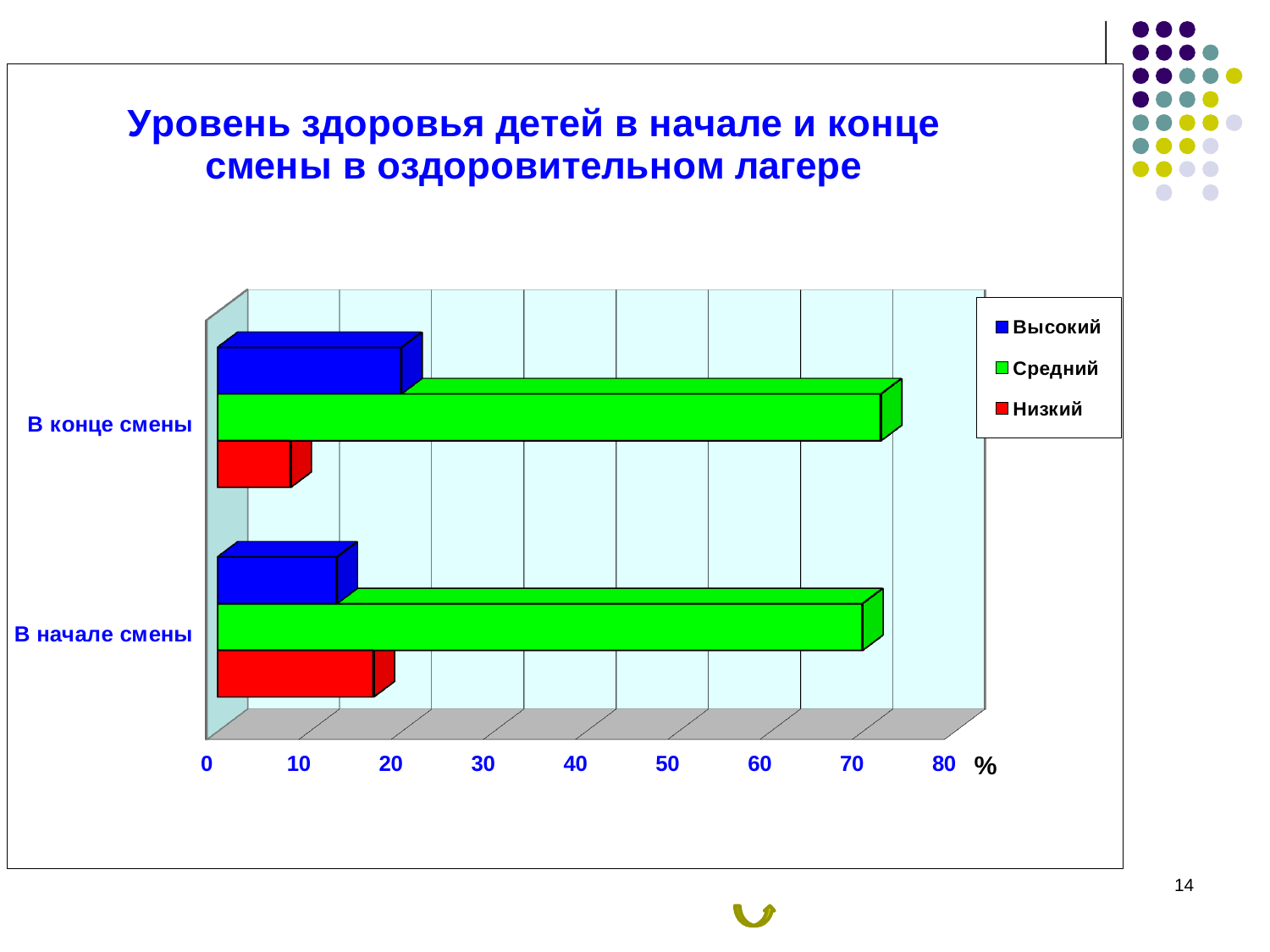
Is the value for "Низкий" in "В начале смены" greater or less than 30? less Which is larger: the "Низкий" value for "В начале смены" or for "В конце смены"? В начале смены Is the value for "Низкий" in "В конце смены" greater or less than 20? less Which colour represents the "Средний" series in the legend? green Which is larger: the "Высокий" value for "В конце смены" or for "В начале смены"? В конце смены Which series has the lowest value for "В конце смены"? Низкий How many series does the legend list? 3 Which series has the highest value for "В конце смены"? Средний Is the value for "Средний" in "В конце смены" greater or less than 60? greater What kind of chart is shown on the slide? bar chart How many categories are shown on the vertical axis? 2